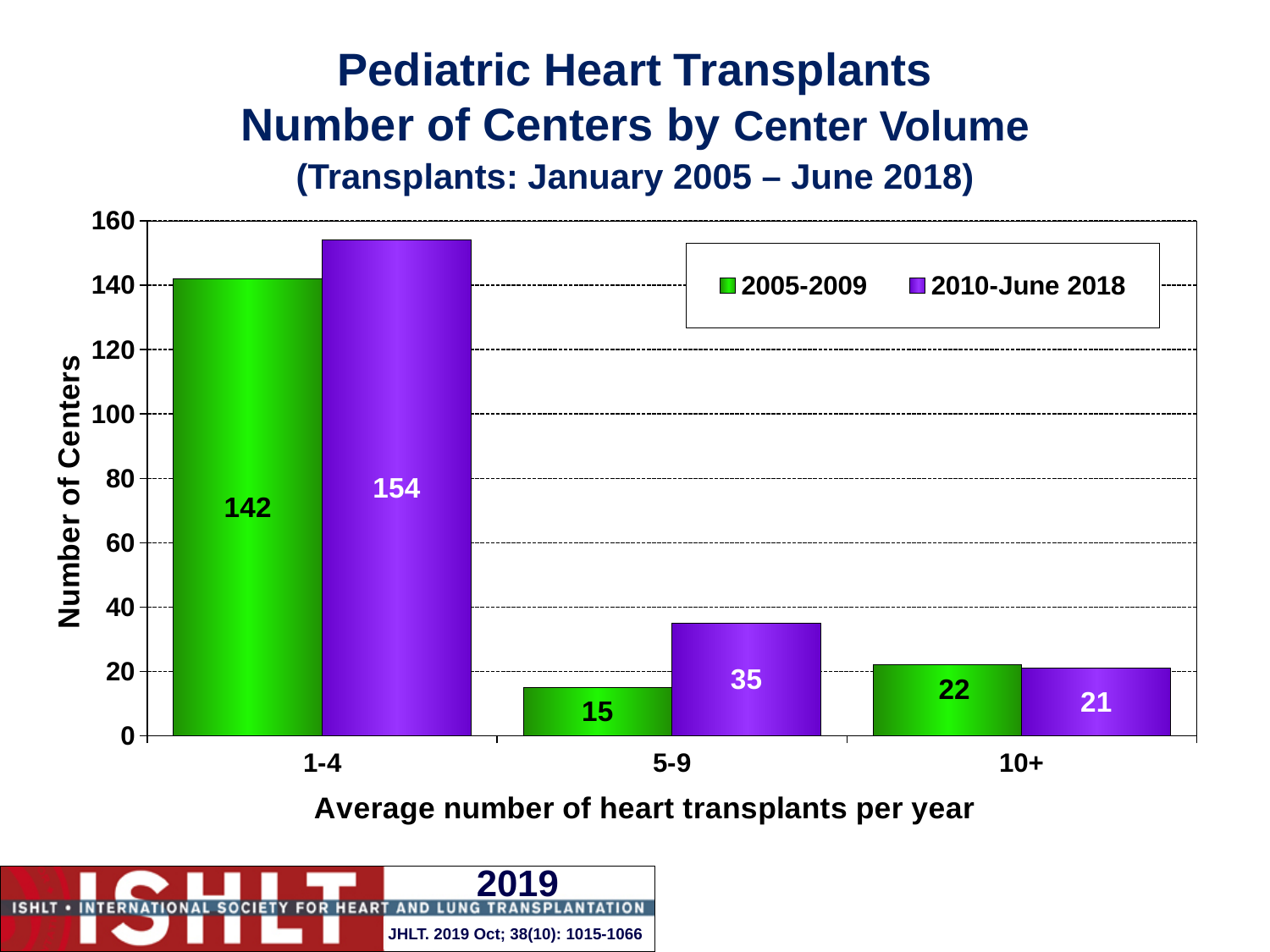
What is the number of centers in the 10+ category for 2005-2009? 22 Which center volume category has the highest number of centers for 2010-June 2018? 1-4 How many center volume categories are shown on the x axis? 3 Which center volume category has the lowest number of centers for 2005-2009? 5-9 How many centers averaged 5-9 heart transplants per year in 2010-June 2018? 35 What is the difference between the 2010-June 2018 and 2005-2009 values for the 5-9 category? 20 What kind of chart is shown on the slide? Bar chart Is the value for 1-4 in 2005-2009 greater or less than 140? greater Which is larger for the 10+ category: the 2005-2009 value or the 2010-June 2018 value? 2005-2009 What is the difference between the 2010-June 2018 and 2005-2009 values for the 1-4 category? 12 How many series does the legend list? 2 How many centers averaged 1-4 heart transplants per year in 2005-2009? 142